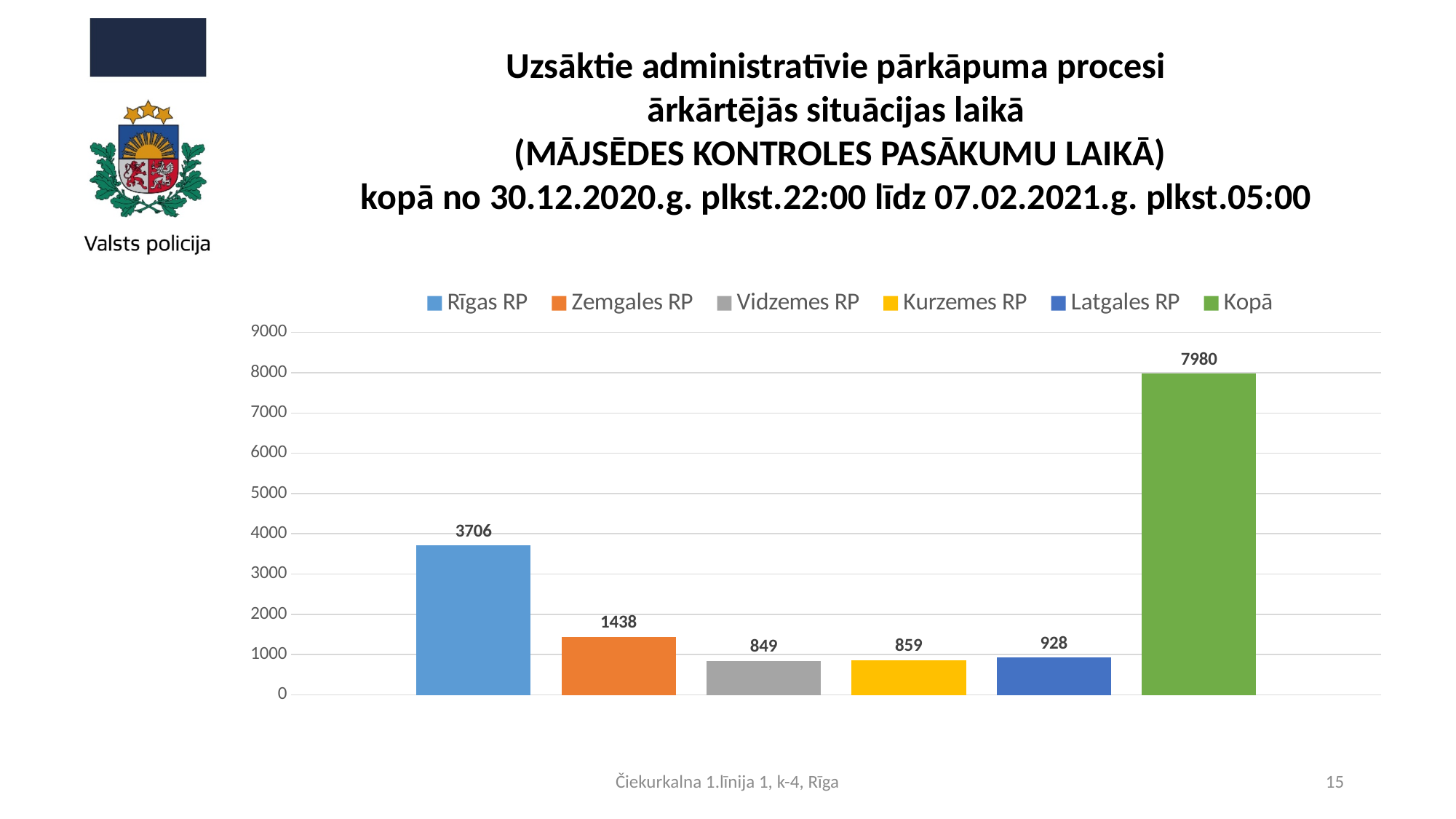
What is the value shown for Kopā? 7980 How many series does the legend list? 6 What is the value for Zemgales RP? 1438 What kind of chart is shown on the slide? Bar chart Which is larger, the value for Latgales RP or Kurzemes RP? Latgales RP Which regional police (RP) has the lowest value? Vidzemes RP What is the value for Latgales RP? 928 What is the value for Rīgas RP? 3706 Which regional police (RP) has the highest value? Rīgas RP Is the value for Zemgales RP greater or less than 1000? greater What is the value for Vidzemes RP? 849 What is the difference between the values for Rīgas RP and Zemgales RP? 2268